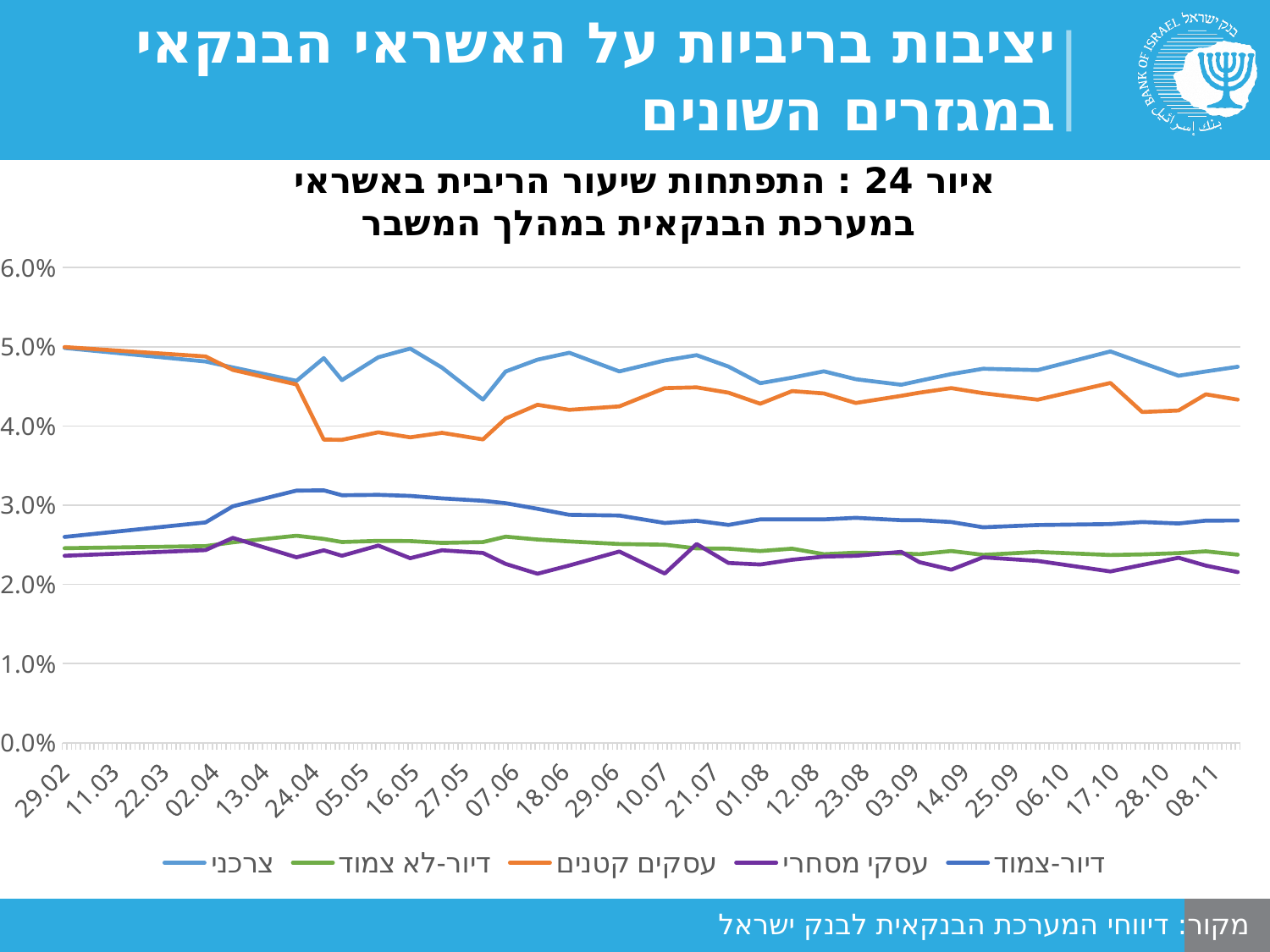
Is the value for צרכני at 16.05 greater or less than 4.0%? greater What is the highest value shown on the y axis? 6.0% How many series does the legend list? 5 At 24.04, which series is higher: דיור-צמוד or עסקי מסחרי? דיור-צמוד Which series has the lowest value at 10.07? עסקי מסחרי Is the value for דיור-צמוד at 24.04 greater or less than 3.0%? greater Is the value for עסקים קטנים at 05.05 greater or less than 5.0%? less Which series has the highest value at 05.05? צרכני Does the עסקים קטנים series rise or fall between 29.02 and 24.04? fall At 05.05, which series is higher: צרכני or עסקים קטנים? צרכני What kind of chart is shown on the slide? line chart Does the דיור-צמוד series rise or fall between 29.02 and 24.04? rise